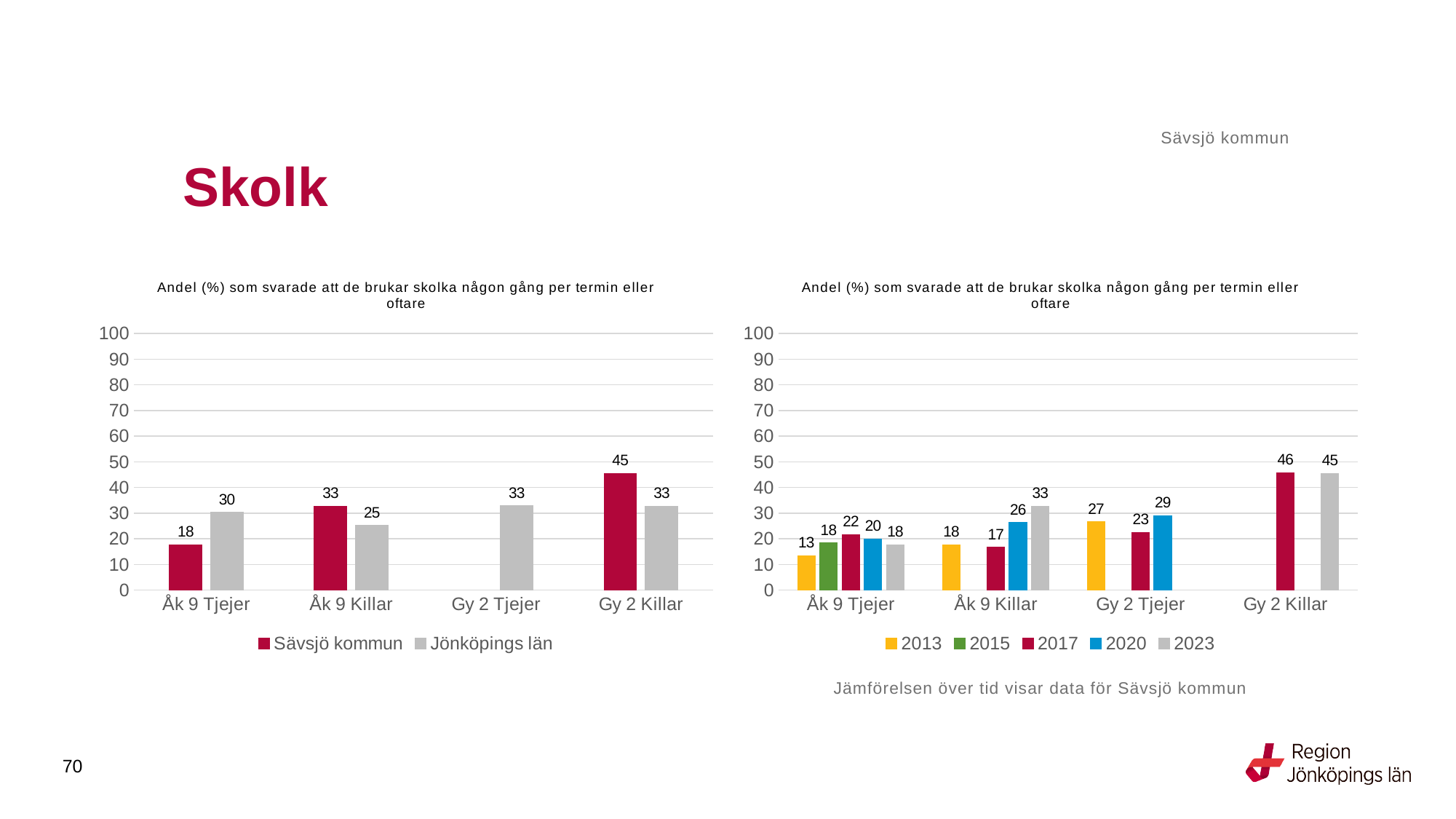
In the left chart, which is larger for Åk 9 Killar: Sävsjö kommun or Jönköpings län? Sävsjö kommun What kind of chart is the right chart? Bar chart In the left chart, what is the value for Jönköpings län for Gy 2 Tjejer? 33 In the right chart, what is the value for 2013 for Gy 2 Tjejer? 27 In the left chart, what is the value for Sävsjö kommun for Åk 9 Tjejer? 18 In the left chart, which category has the highest value for Sävsjö kommun? Gy 2 Killar In the right chart, what is the value for 2020 for Åk 9 Killar? 26 In the right chart, which year has the lowest value for Åk 9 Tjejer? 2013 In the left chart, what is the difference between Sävsjö kommun and Jönköpings län for Gy 2 Killar? 12 In the right chart, how many series does the legend list? 5 In the right chart, what is the difference between 2017 and 2023 for Gy 2 Killar? 1 In the left chart, how many series does the legend list? 2